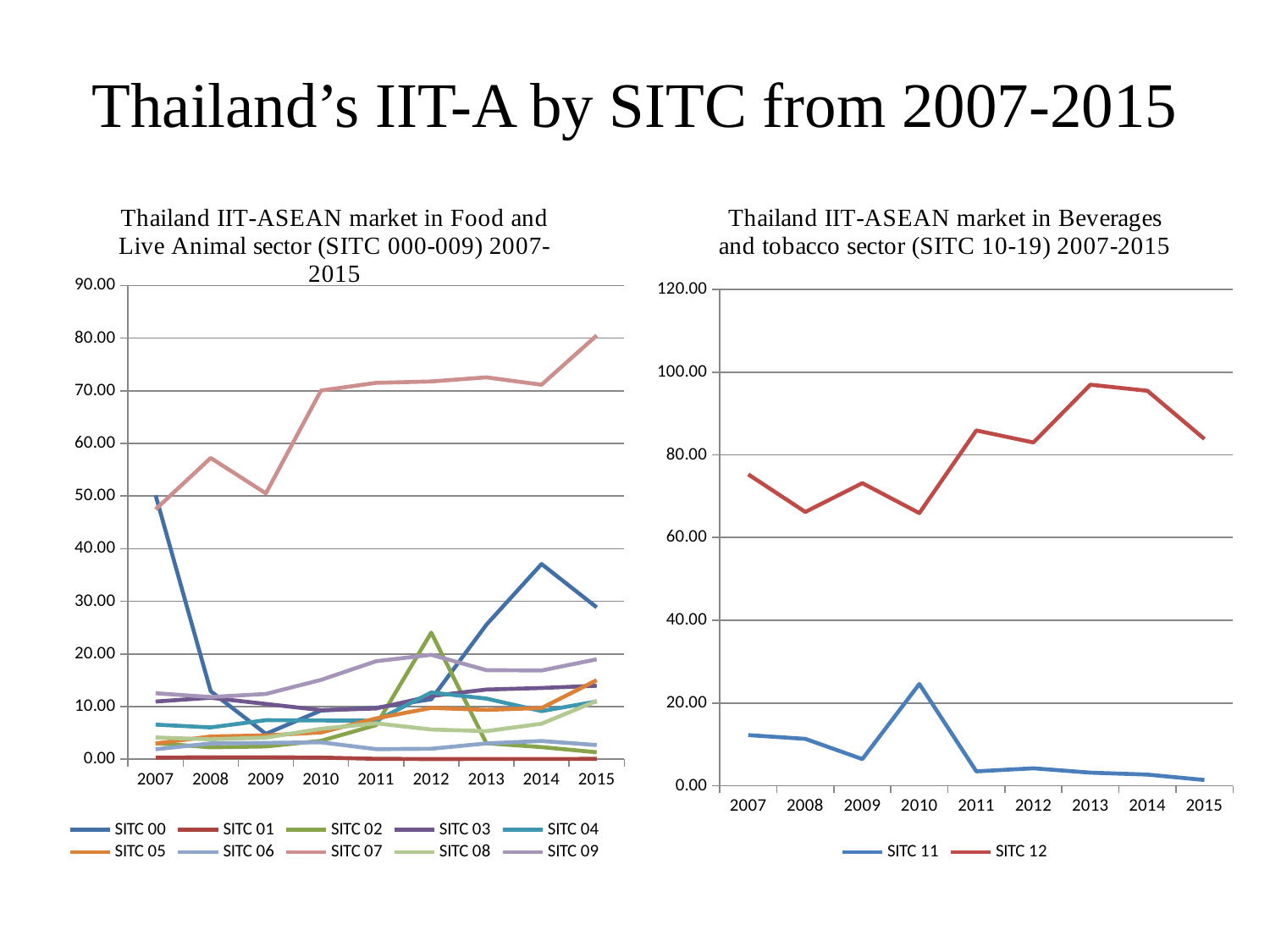
In the left chart (Food and Live Animal sector), is the value for SITC 00 in 2014 greater or less than 30? greater In the right chart (Beverages and tobacco sector), in which year does SITC 11 reach its highest value? 2010 How many years are shown on the x axis of the right chart (Beverages and tobacco sector)? 9 In the left chart (Food and Live Animal sector), which series has the highest value in 2015? SITC 07 How many series does the legend of the right chart (Beverages and tobacco sector) list? 2 What kind of chart is the left chart, 'Thailand IIT-ASEAN market in Food and Live Animal sector (SITC 000-009) 2007-2015'? line chart In the left chart (Food and Live Animal sector), in which year is SITC 00 at its lowest? 2009 In the right chart (Beverages and tobacco sector), is the value for SITC 12 in 2010 greater or less than 80? less In the right chart (Beverages and tobacco sector), is the value for SITC 12 in 2013 greater or less than 80? greater How many series does the legend of the left chart (Food and Live Animal sector) list? 10 In the right chart (Beverages and tobacco sector), which series has the larger value in 2007, SITC 11 or SITC 12? SITC 12 In the right chart (Beverages and tobacco sector), does SITC 11 rise or fall from 2010 to 2015? fall